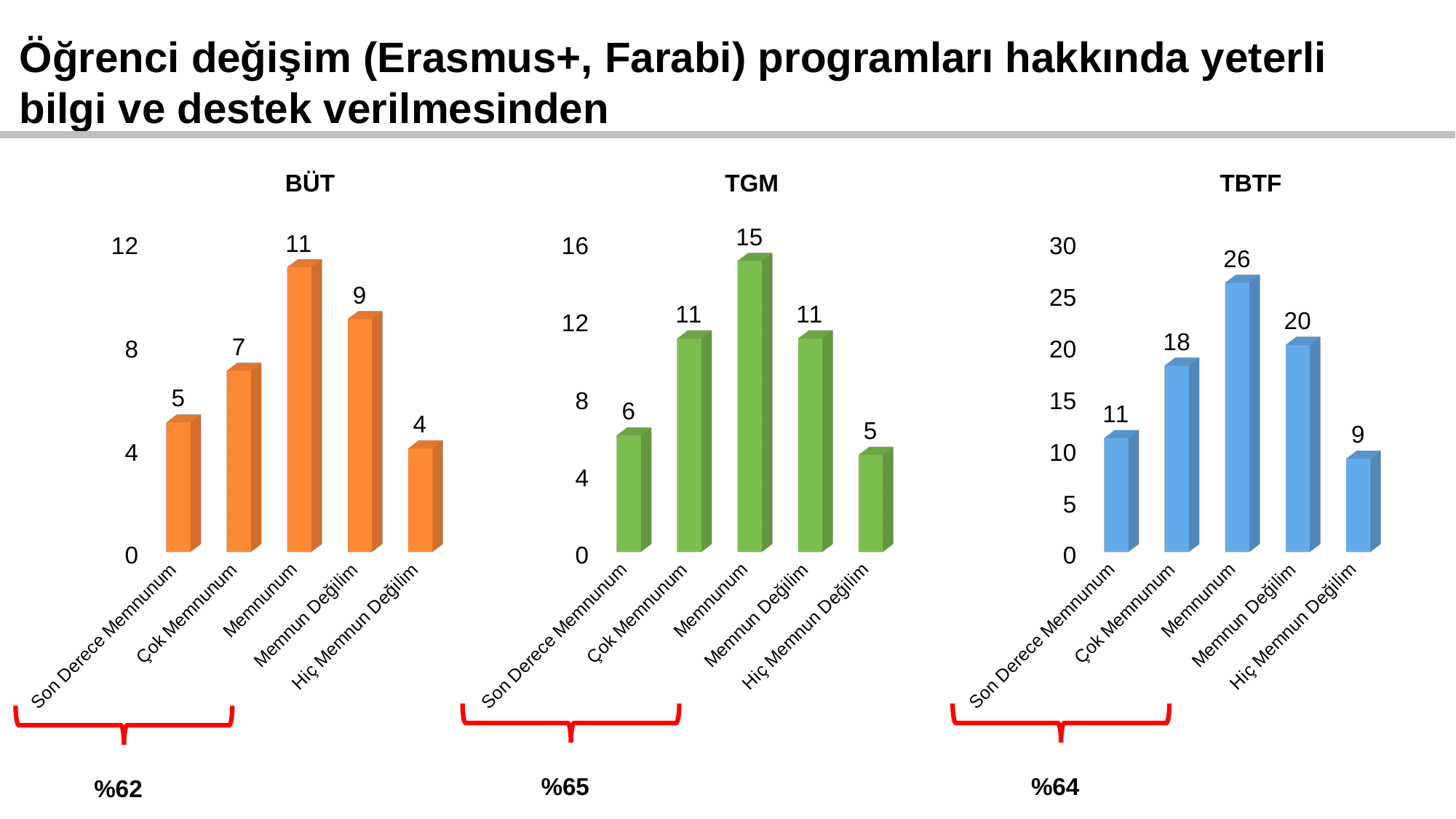
In the BÜT chart, which category has the lowest value? Hiç Memnun Değilim In the TBTF chart, what is the value for Memnun Değilim? 20 What percentage is shown under the bracket below the TGM chart? %65 In the BÜT chart, what is the value for Memnunum? 11 In the TBTF chart, which is larger: Çok Memnunum or Son Derece Memnunum? Çok Memnunum In the TBTF chart, what is the difference between Memnunum and Memnun Değilim? 6 In the TBTF chart, which category has the highest value? Memnunum In the BÜT chart, is the value for Memnun Değilim greater or less than 8? greater How many categories does the TGM chart show? 5 In the TGM chart, what is the difference between Memnunum and Hiç Memnun Değilim? 10 In the TGM chart, what is the value for Son Derece Memnunum? 6 What kind of chart is the TBTF chart? bar chart